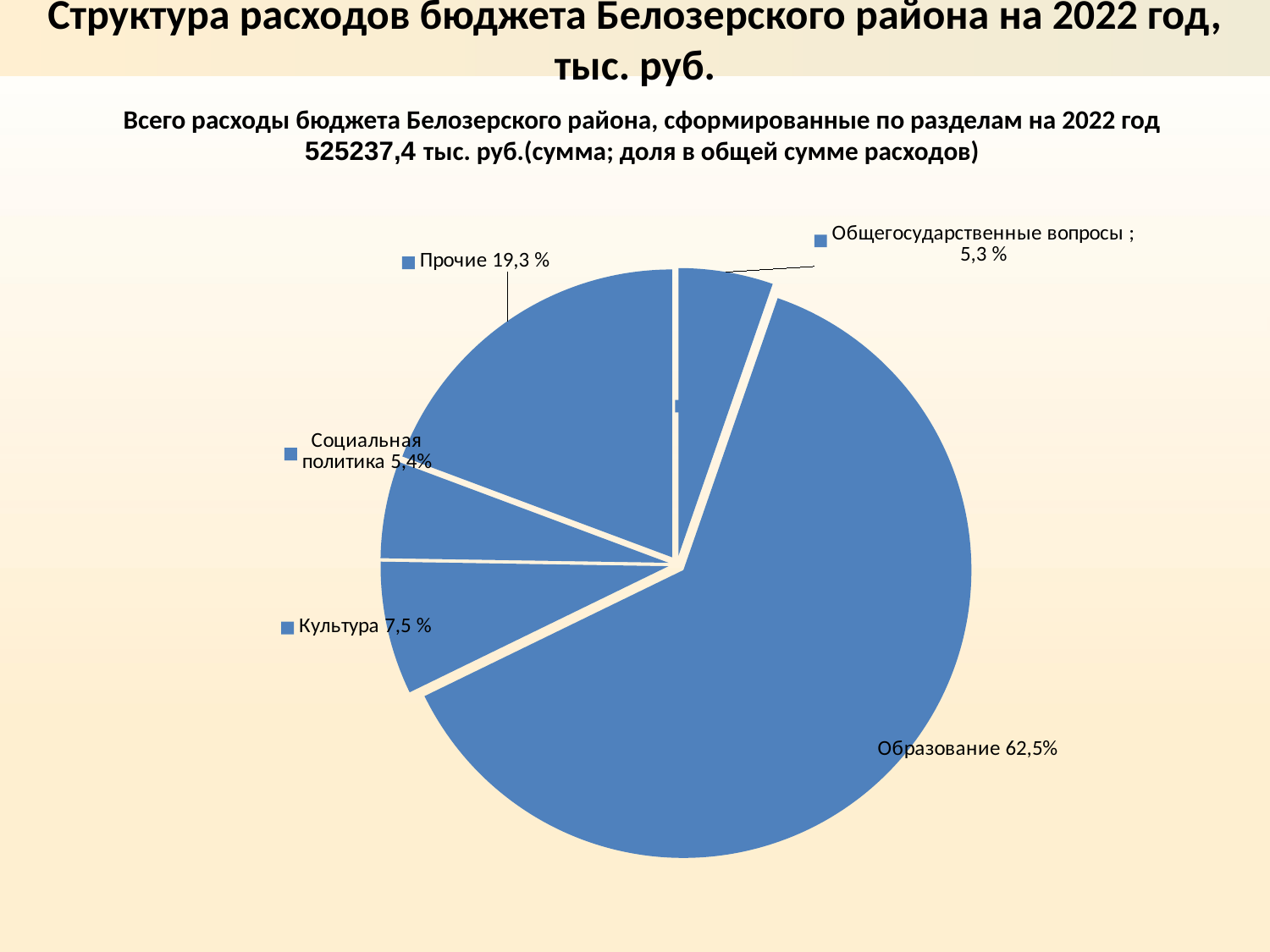
By how many percentage points does the share for Образование exceed the share for Прочие? 43,2 What share of expenditures does Образование account for? 62,5% What share of expenditures does Прочие account for? 19,3 % Which category has the largest share of the pie? Образование How many labeled categories are shown in the pie chart? 5 What kind of chart is shown on the slide? pie chart What is the total budget expenditure stated above the chart, in тыс. руб.? 525237,4 What share of expenditures does Общегосударственные вопросы account for? 5,3 % Which labeled category has the smallest share of the pie? Общегосударственные вопросы What share of expenditures does Социальная политика account for? 5,4% Which is larger, the share for Культура or the share for Прочие? Прочие What share of expenditures does Культура account for? 7,5 %